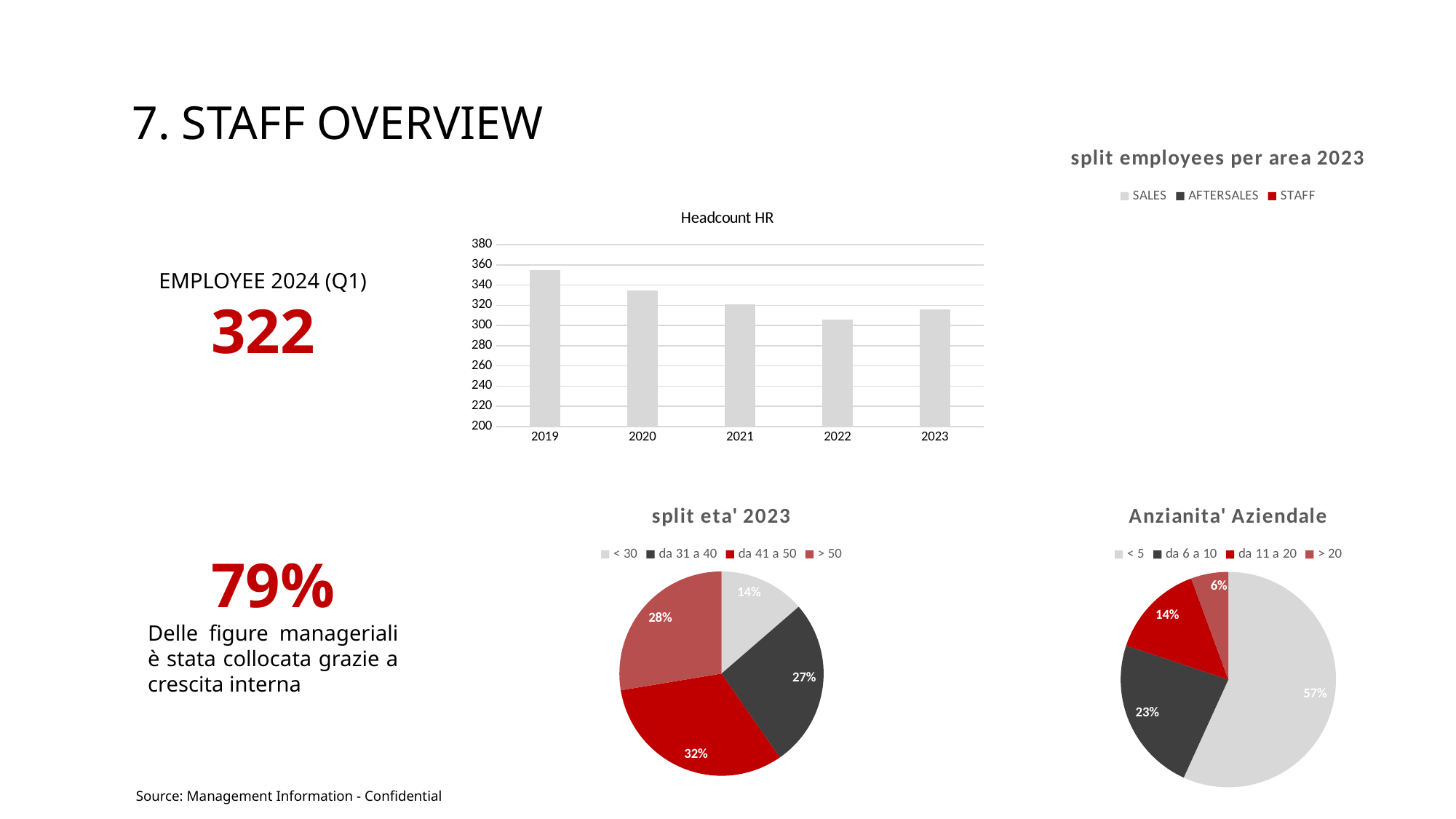
In the split eta' 2023 pie chart, which age group has the smallest share? < 30 In the Headcount HR chart, is the value for 2022 greater or less than 320? less In the Headcount HR chart, how many years are shown on the x axis? 5 In the Headcount HR chart, does the headcount rise or fall from 2019 to 2022? fall How many series does the legend of the split employees per area 2023 chart list? 3 What kind of chart is the Headcount HR chart? bar chart In the Headcount HR chart, which year has the highest headcount? 2019 In the Headcount HR chart, is the value for 2019 greater or less than 340? greater In the split eta' 2023 pie chart, what share is the 'da 41 a 50' slice? 32% In the Anzianita' Aziendale pie chart, what is the difference between the 'da 6 a 10' and 'da 11 a 20' shares? 9% In the Headcount HR chart, which year has the lowest headcount? 2022 In the Anzianita' Aziendale pie chart, what share is the '< 5' slice? 57%